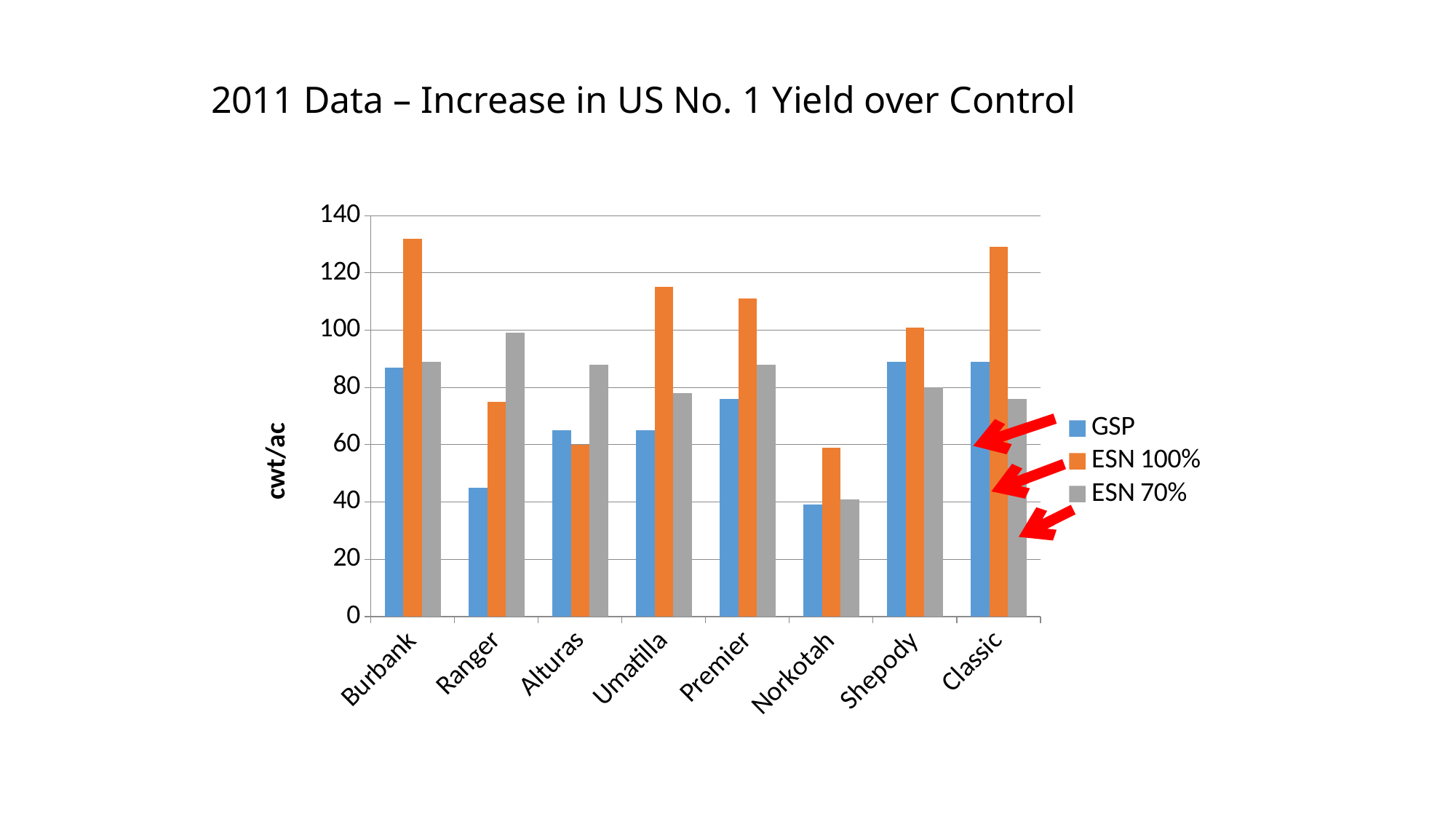
How many potato varieties are shown along the x axis? 8 What kind of chart is shown on the slide? bar chart For Ranger, which is larger: the GSP value or the ESN 70% value? ESN 70% Is the ESN 100% value for Umatilla greater or less than 100? greater Which series is shown in orange? ESN 100% Is the ESN 70% value for Ranger greater or less than 80? greater Which variety has the highest ESN 70% value? Ranger Is the GSP value for Norkotah greater or less than 60? less Which variety has the lowest GSP value? Norkotah How many series does the legend list? 3 What is the label on the vertical axis? cwt/ac